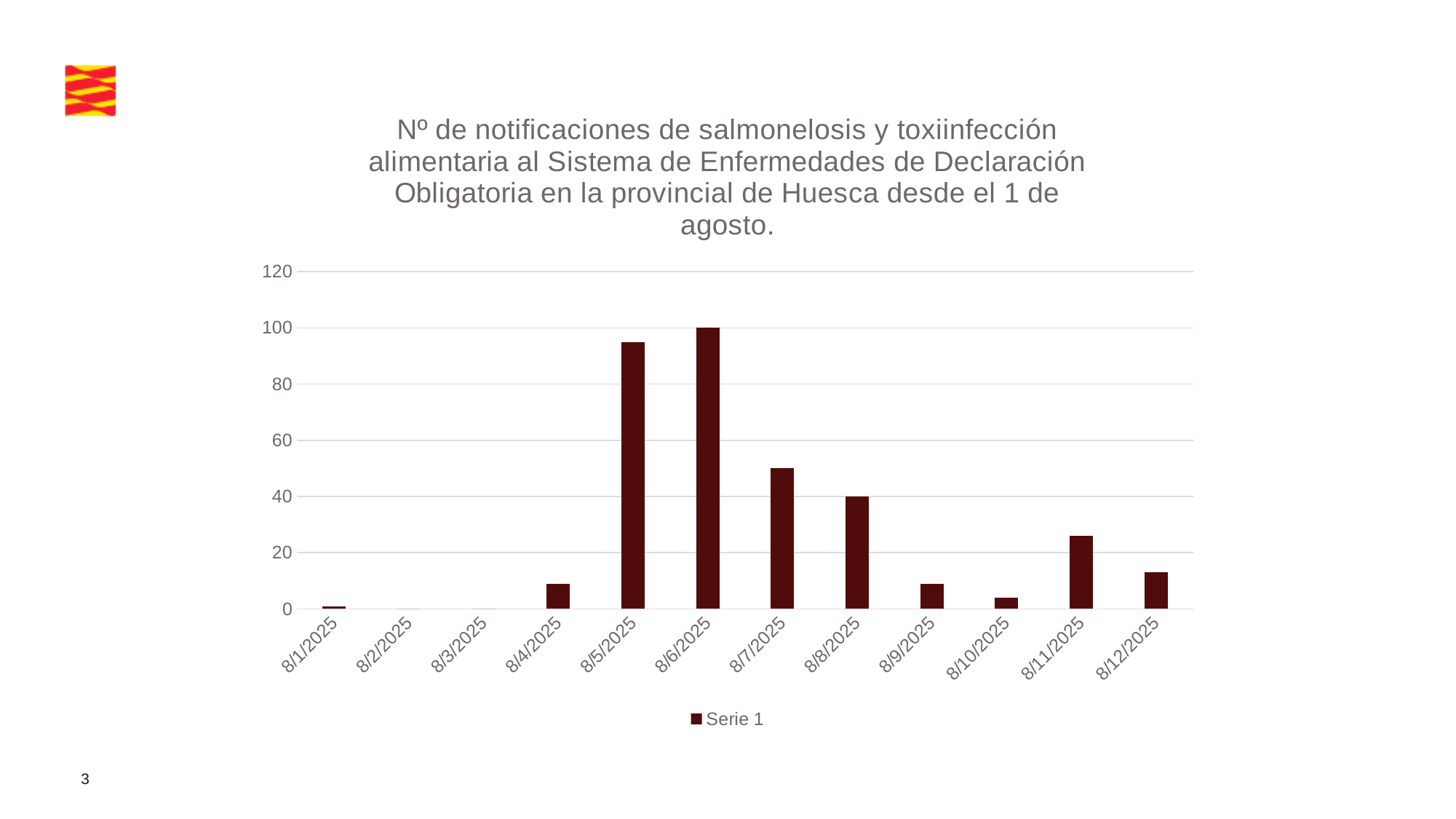
What type of chart is shown on the slide? bar chart Is the value for 8/7/2025 greater or less than 60? less What is the value for 8/8/2025? 40 How many dates are shown on the x axis of the chart? 12 What is the name of the series shown in the legend? Serie 1 Is the value for 8/5/2025 greater or less than 80? greater How many series does the legend list? 1 Which date has the highest number of notifications? 8/6/2025 What is the value for 8/6/2025? 100 Do the values rise or fall from 8/6/2025 to 8/10/2025? fall Is the value for 8/11/2025 greater or less than 20? greater Which is larger, the value for 8/5/2025 or the value for 8/7/2025? 8/5/2025